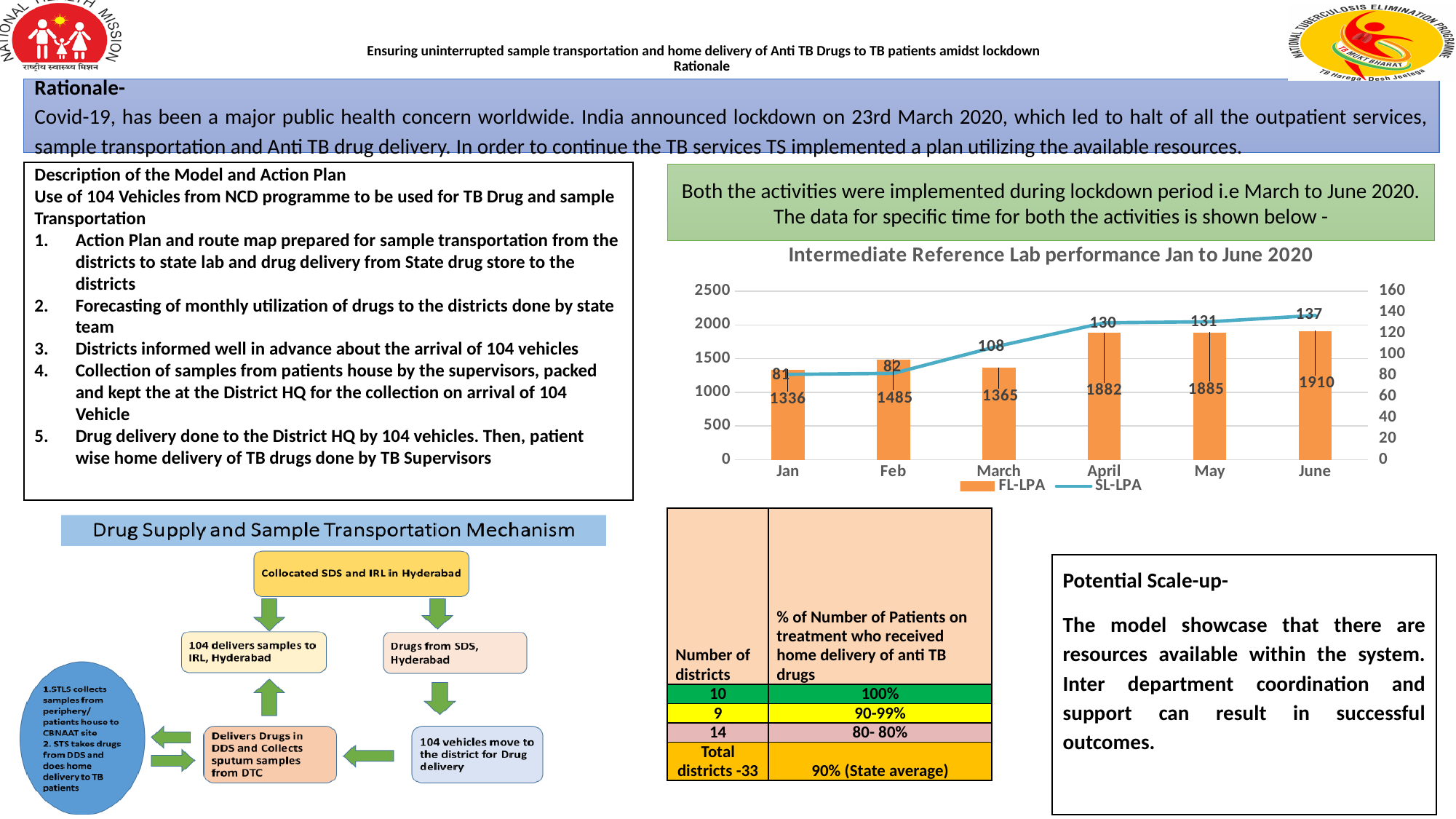
What is the SL-LPA value for March in the Intermediate Reference Lab performance chart? 108 What is the difference between the FL-LPA values for June and Jan in the Intermediate Reference Lab performance chart? 574 What is the difference between the SL-LPA values for June and May in the Intermediate Reference Lab performance chart? 6 Which month has the highest FL-LPA value in the Intermediate Reference Lab performance chart? June What is the FL-LPA value for April in the Intermediate Reference Lab performance chart? 1882 Does the SL-LPA line rise or fall from Jan to June in the Intermediate Reference Lab performance chart? rise Which month has the lowest SL-LPA value in the Intermediate Reference Lab performance chart? Jan What is the FL-LPA value for Jan in the Intermediate Reference Lab performance chart? 1336 Which series in the Intermediate Reference Lab performance chart is drawn as a line? SL-LPA How many months are shown on the x axis of the Intermediate Reference Lab performance chart? 6 In the Intermediate Reference Lab performance chart, is the FL-LPA value higher in Feb or in March? Feb How many series does the legend of the Intermediate Reference Lab performance chart list? 2